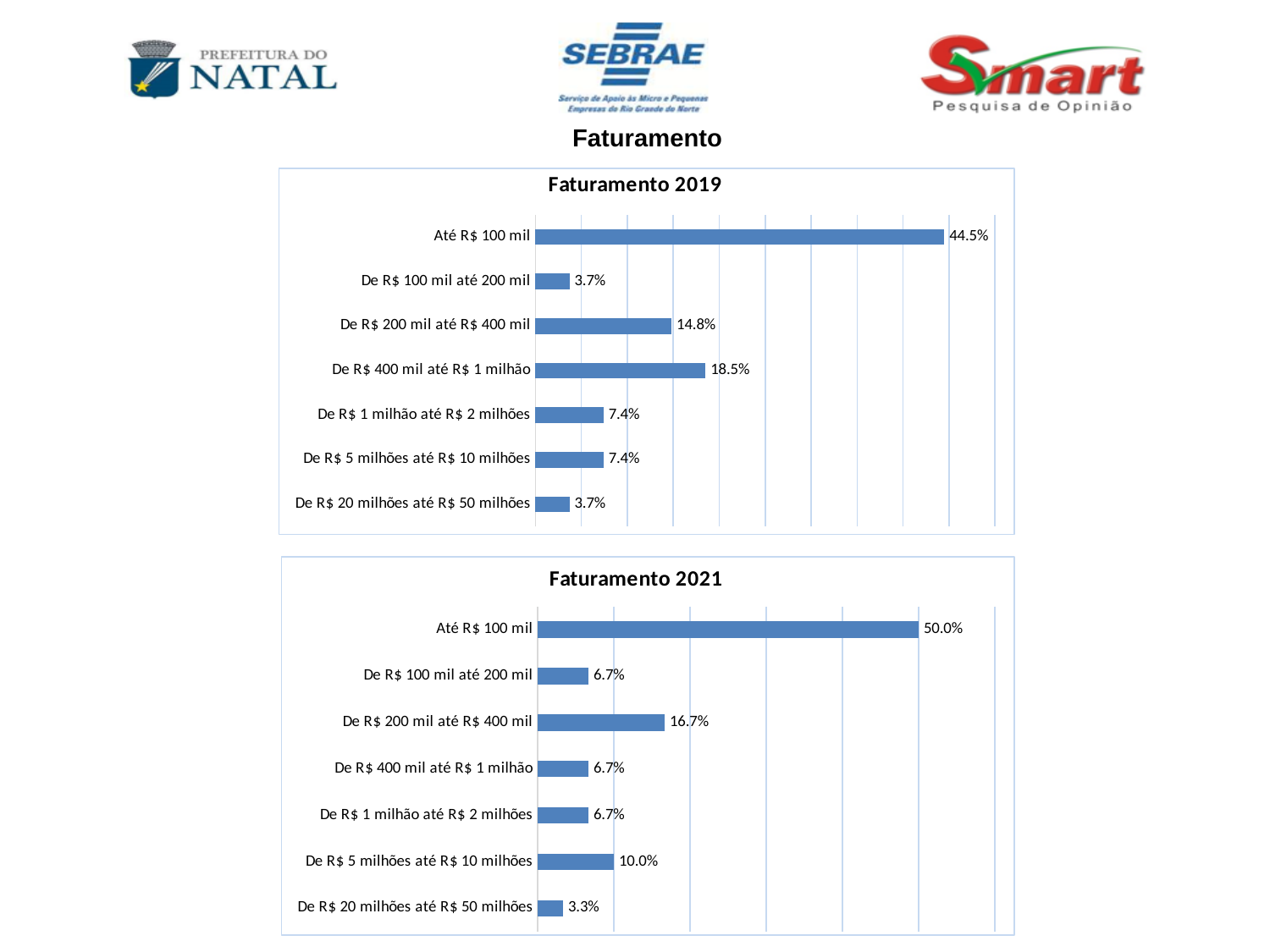
In the Faturamento 2019 chart, what is the value for De R$ 20 milhões até R$ 50 milhões? 3.7% In the Faturamento 2019 chart, what is the value for Até R$ 100 mil? 44.5% In the Faturamento 2019 chart, what is the difference between the values for Até R$ 100 mil and De R$ 400 mil até R$ 1 milhão? 26.0% In the Faturamento 2021 chart, which category has the lowest value? De R$ 20 milhões até R$ 50 milhões In the Faturamento 2021 chart, what is the value for De R$ 5 milhões até R$ 10 milhões? 10.0% How many categories does the Faturamento 2021 chart show? 7 What is the title of the top chart on the slide? Faturamento 2019 In the Faturamento 2019 chart, which is larger: the value for De R$ 200 mil até R$ 400 mil or the value for De R$ 1 milhão até R$ 2 milhões? De R$ 200 mil até R$ 400 mil In the Faturamento 2019 chart, what is the value for De R$ 400 mil até R$ 1 milhão? 18.5% What kind of chart is the Faturamento 2019 chart? Bar chart In the Faturamento 2021 chart, what is the difference between the values for De R$ 200 mil até R$ 400 mil and De R$ 100 mil até 200 mil? 10.0% In the Faturamento 2021 chart, which category has the highest value? Até R$ 100 mil